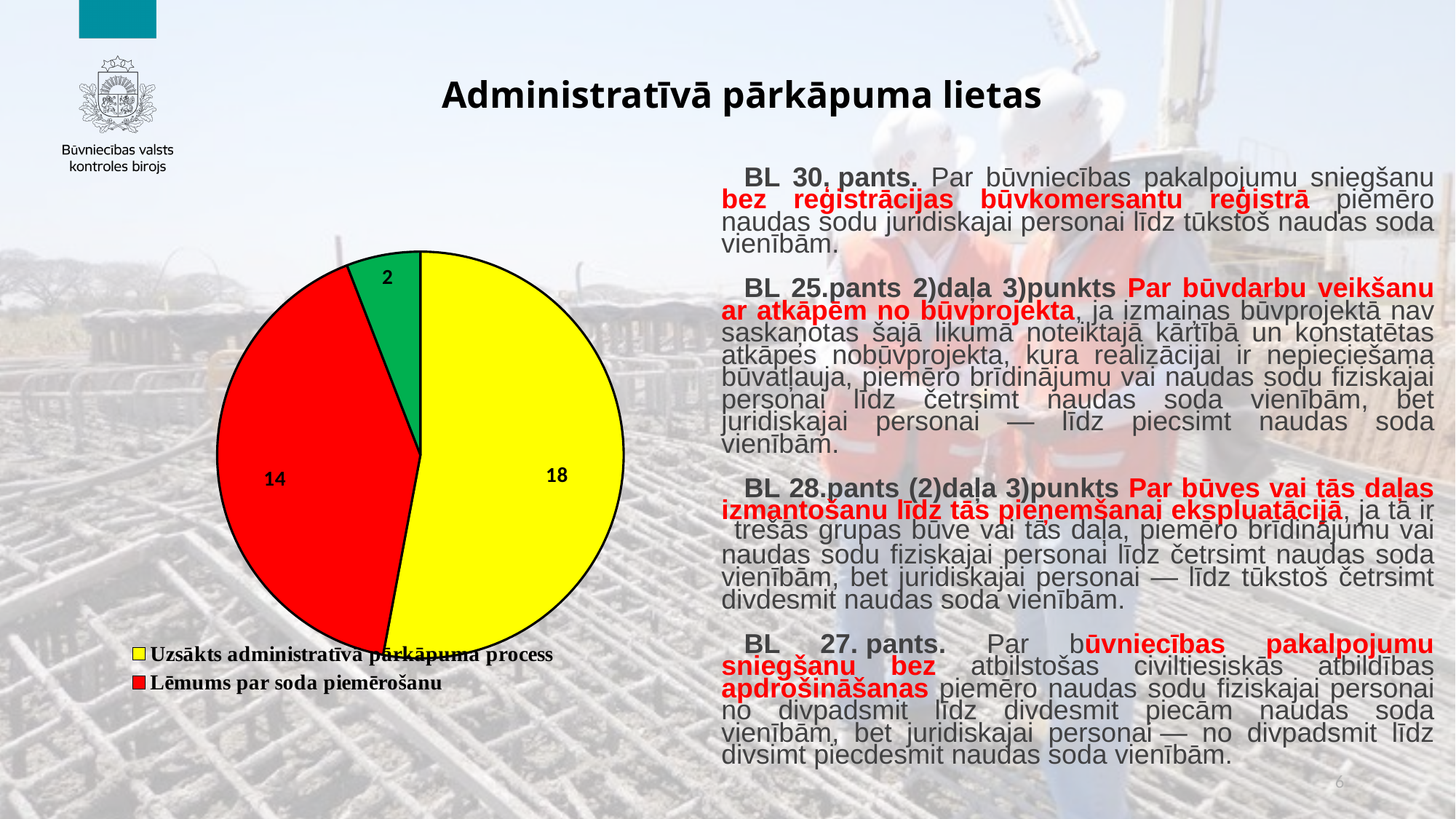
Which slice of the pie chart has the smallest value? the green slice (2) What type of chart is shown on the slide? pie chart What value is shown on the green slice of the pie chart? 2 Which is larger: "Uzsākts administratīvā pārkāpuma process" or "Lēmums par soda piemērošanu"? Uzsākts administratīvā pārkāpuma process What is the value of the slice for "Lēmums par soda piemērošanu"? 14 What colour is the slice for "Lēmums par soda piemērošanu"? red Which slice of the pie chart has the largest value? Uzsākts administratīvā pārkāpuma process What is the total of all the values shown on the pie chart? 34 What is the value of the slice for "Uzsākts administratīvā pārkāpuma process"? 18 What is the difference between the values for "Uzsākts administratīvā pārkāpuma process" and "Lēmums par soda piemērošanu"? 4 How many entries does the chart legend list? 2 How many slices does the pie chart have? 3